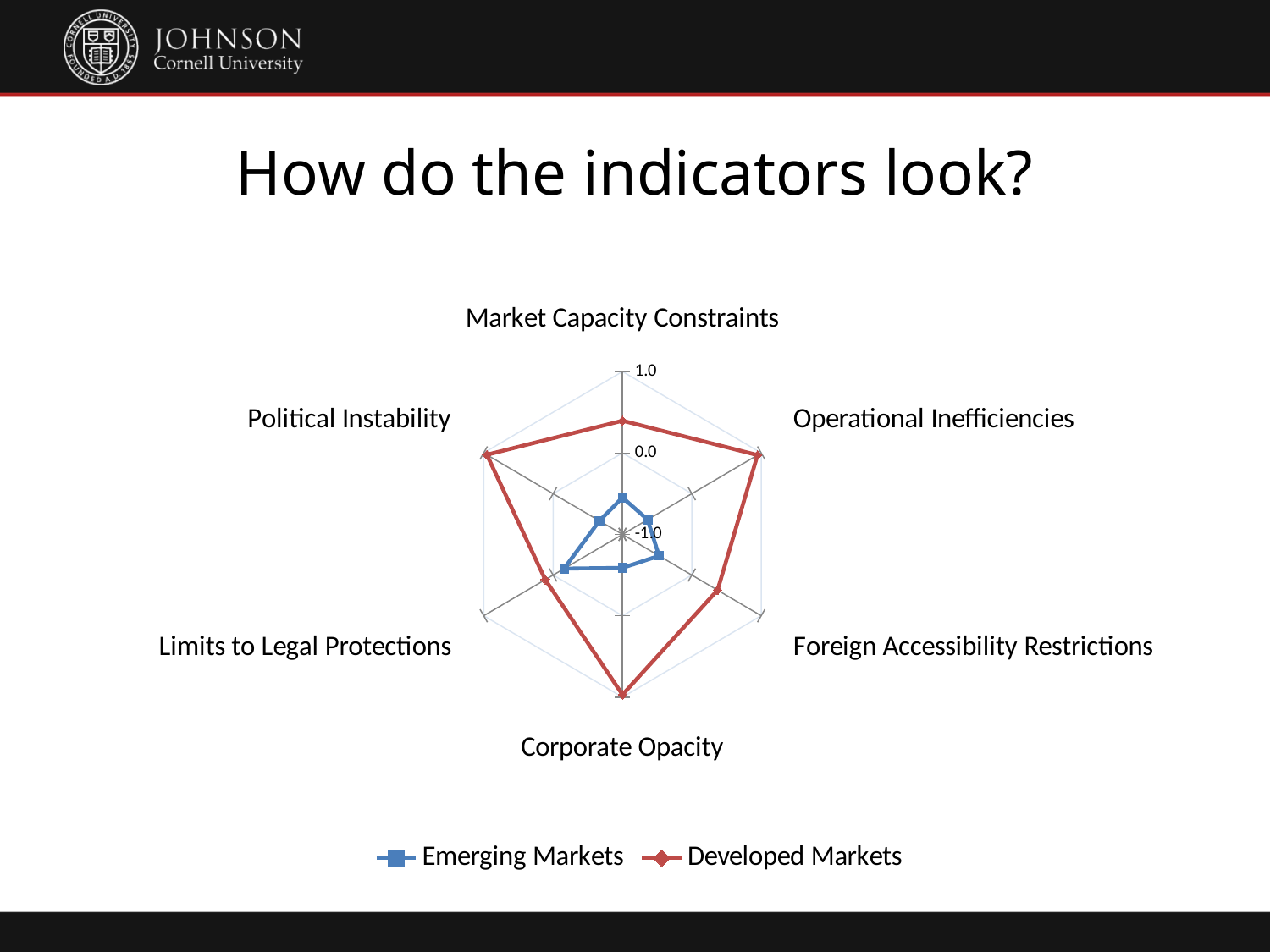
How many series does the legend list? 2 Is the Emerging Markets value for Corporate Opacity greater or less than 0.0? less What is the title of the slide containing the radar chart? How do the indicators look? Which series has the larger value for Political Instability, Emerging Markets or Developed Markets? Developed Markets For the Developed Markets series, which is larger: Corporate Opacity or Limits to Legal Protections? Corporate Opacity How many indicator categories (axes) does the radar chart have? 6 Which series is drawn in red with diamond markers? Developed Markets What kind of chart is shown on the slide? Radar chart Is the Developed Markets value for Market Capacity Constraints greater or less than 0.0? greater For the Emerging Markets series, which indicator has the highest value? Limits to Legal Protections Is the Developed Markets value for Foreign Accessibility Restrictions greater or less than 0.0? greater